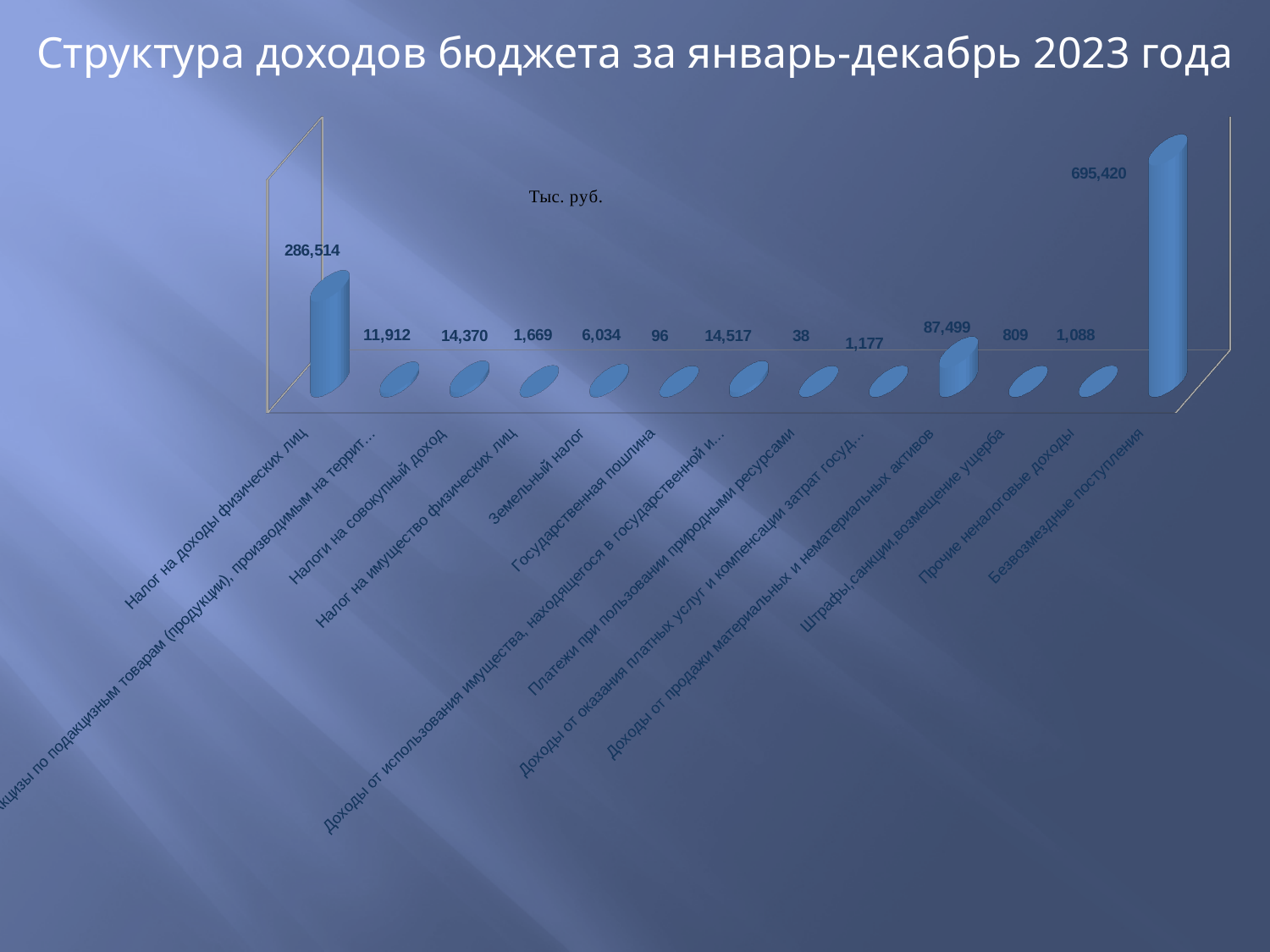
What is the value for Штрафы, санкции, возмещение ущерба? 809 What is the difference between the values for Безвозмездные поступления and Налог на доходы физических лиц? 408,906 What unit is indicated on the chart? Тыс. руб. What is the value for Земельный налог? 6,034 Which category has the highest value? Безвозмездные поступления What is the value for Государственная пошлина? 96 What is the value for Безвозмездные поступления? 695,420 Which category has the lowest value? Платежи при пользовании природными ресурсами How many categories are shown in the chart? 13 What kind of chart is shown on the slide? Bar chart Which is larger: the value for Налоги на совокупный доход or the value for Земельный налог? Налоги на совокупный доход What is the value for Налог на доходы физических лиц? 286,514